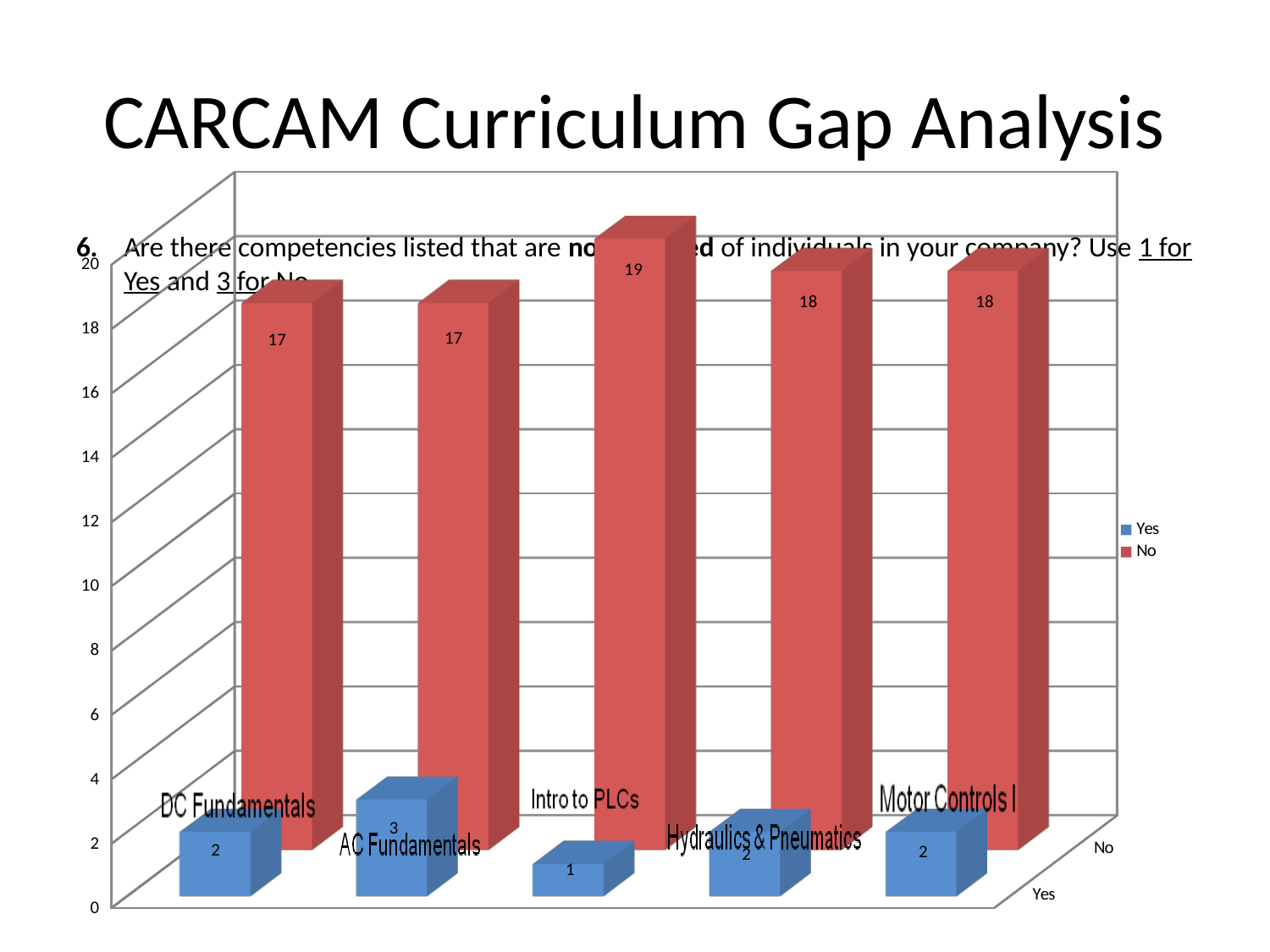
What kind of chart is shown on the slide? Bar chart What is the value for "Yes" for AC Fundamentals? 3 What is the value for "No" for DC Fundamentals? 17 What is the difference between the "No" and "Yes" values for Motor Controls I? 16 Which category has the highest "No" value? Intro to PLCs What is the value for "No" for Intro to PLCs? 19 Which is larger for Hydraulics & Pneumatics, the "Yes" value or the "No" value? No How many series does the legend list? 2 Which category has the highest "Yes" value? AC Fundamentals What is the value for "Yes" for Intro to PLCs? 1 Which category has the lowest "Yes" value? Intro to PLCs How many categories are shown on the x axis? 5